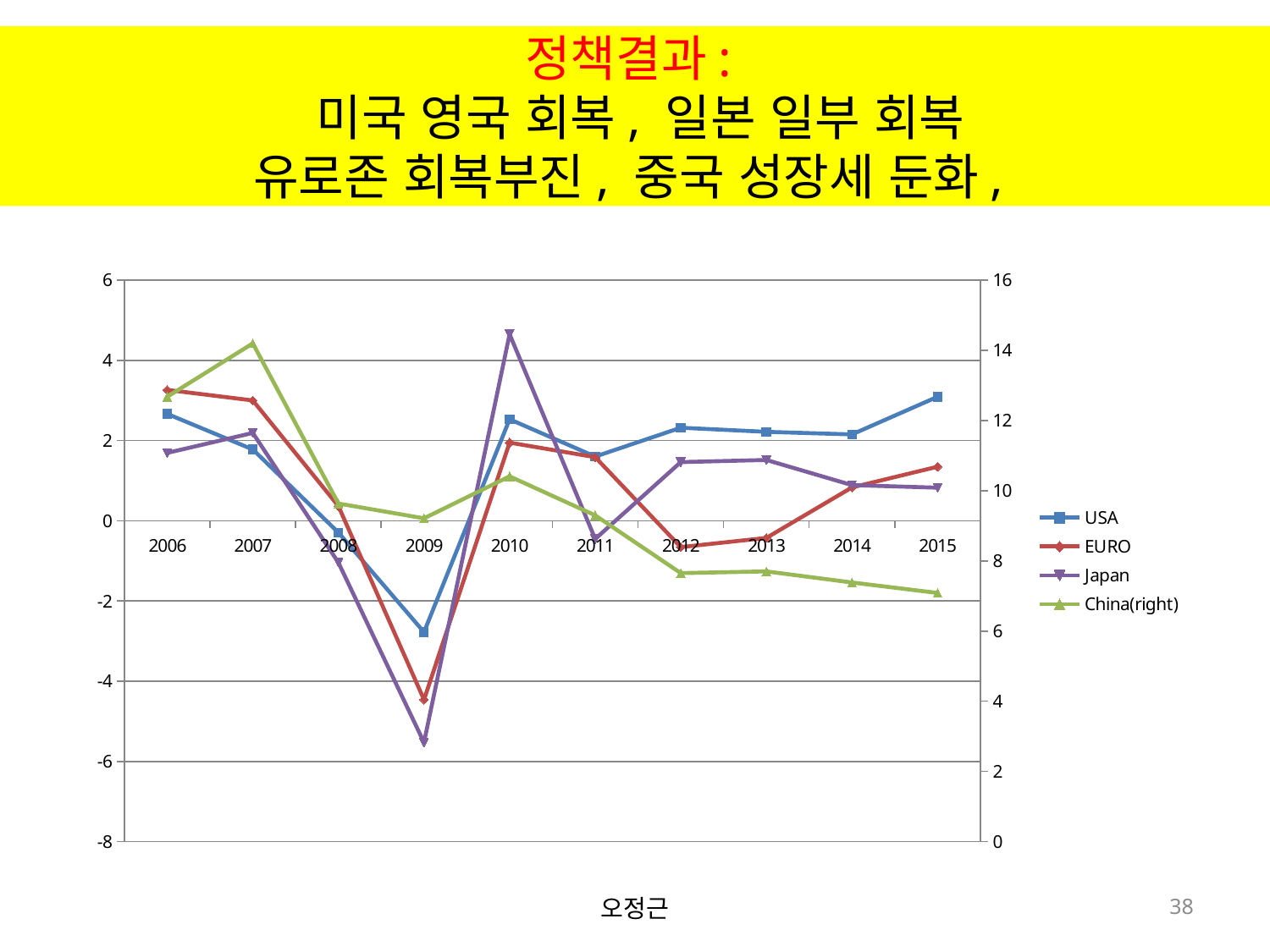
How many series does the legend list? 4 In which year does the EURO series reach its lowest value? 2009 What kind of chart is shown on the slide? line chart In 2010, which is higher, the USA value or the Japan value? Japan Is the value for China(right) in 2015 greater or less than 8 on the right axis? less Is the value for Japan in 2010 greater or less than 4? greater Does the China(right) series rise or fall from 2012 to 2015? fall In which year does the Japan series reach its lowest value? 2009 Which series is plotted against the right-hand axis? China(right) How many years are plotted along the x axis? 10 Is the value for USA in 2009 greater or less than -2? less